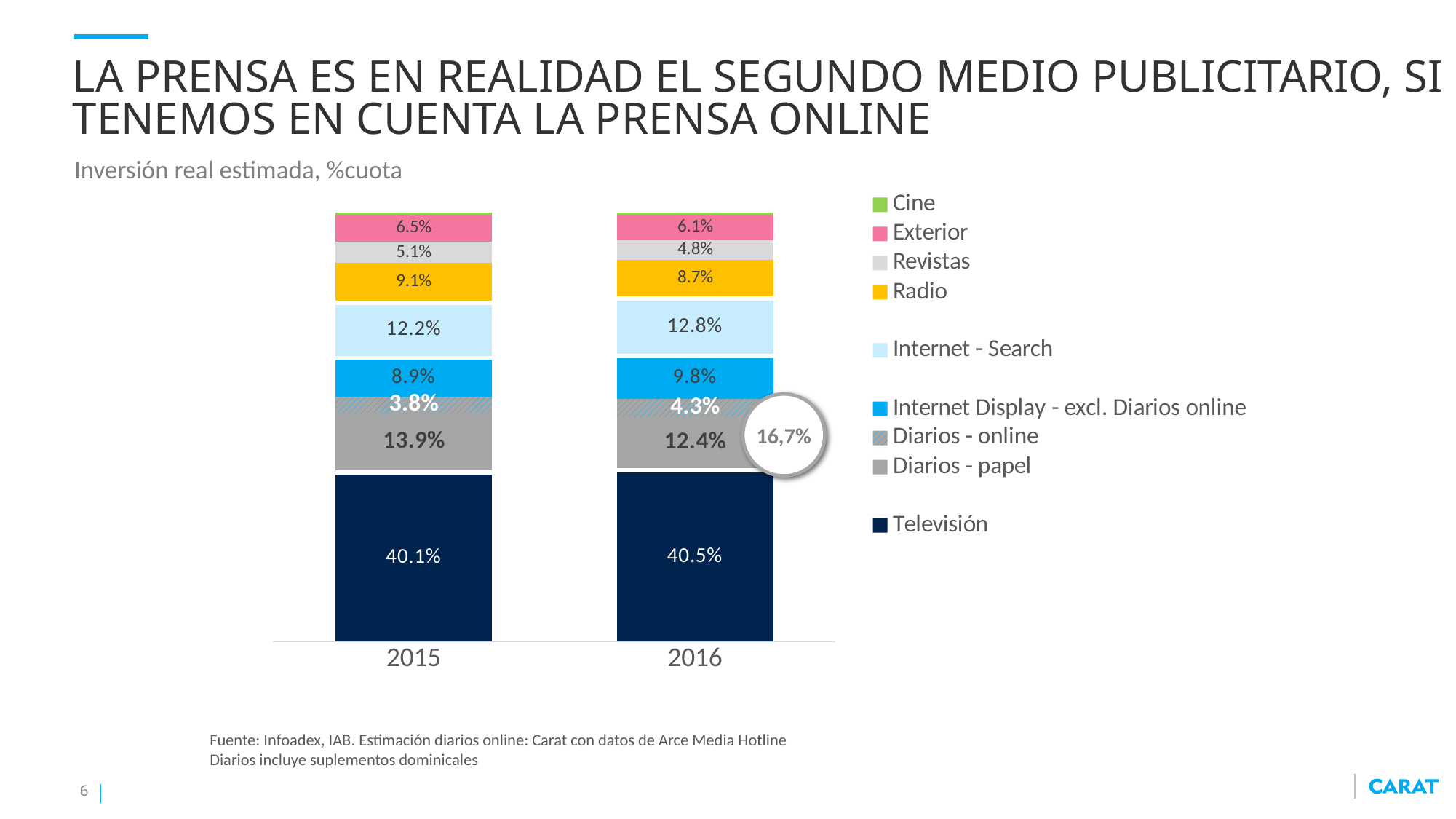
What combined share is shown in the circled callout next to the 2016 bar? 16,7% What is the share for Internet - Search in 2016? 12.8% What kind of chart is shown on the slide? Stacked bar chart Which series has the largest share in 2016? Televisión Which labelled series has the smallest share in 2015? Diarios - online What is the share for Diarios - online in 2015? 3.8% How many series does the legend list? 9 How many years (categories) are plotted on the x axis? 2 By how many percentage points did the Diarios - papel share fall from 2015 to 2016? 1.5 What is the share for Televisión in 2016? 40.5% What is the share for Diarios - papel in 2015? 13.9% Which is larger: the Radio share in 2015 or in 2016? 2015